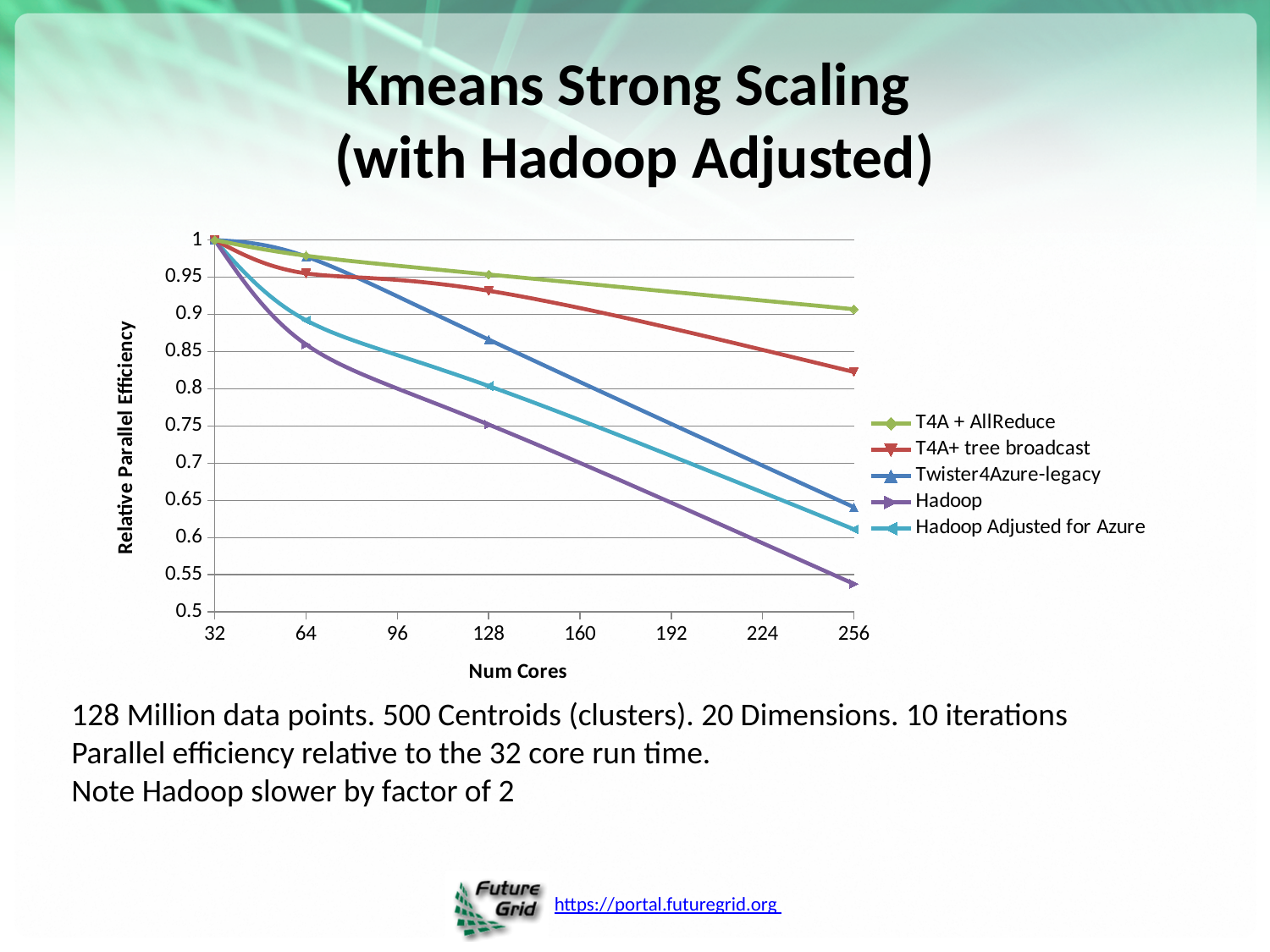
Do the values for Hadoop rise or fall as the number of cores increases? fall Is the value for Twister4Azure-legacy at 128 cores greater or less than 0.8? greater What is the relative parallel efficiency of Hadoop at 32 cores? 1 What kind of chart is shown on the slide? line chart What is the label of the x axis? Num Cores At 256 cores, which is larger: Hadoop or Hadoop Adjusted for Azure? Hadoop Adjusted for Azure Which series has the highest relative parallel efficiency at 256 cores? T4A + AllReduce How many series does the legend list? 5 Is the value for Hadoop at 256 cores greater or less than 0.6? less Is the value for T4A + AllReduce at 256 cores greater or less than 0.85? greater Which series has the lowest relative parallel efficiency at 256 cores? Hadoop At 128 cores, which is larger: T4A+ tree broadcast or Twister4Azure-legacy? T4A+ tree broadcast